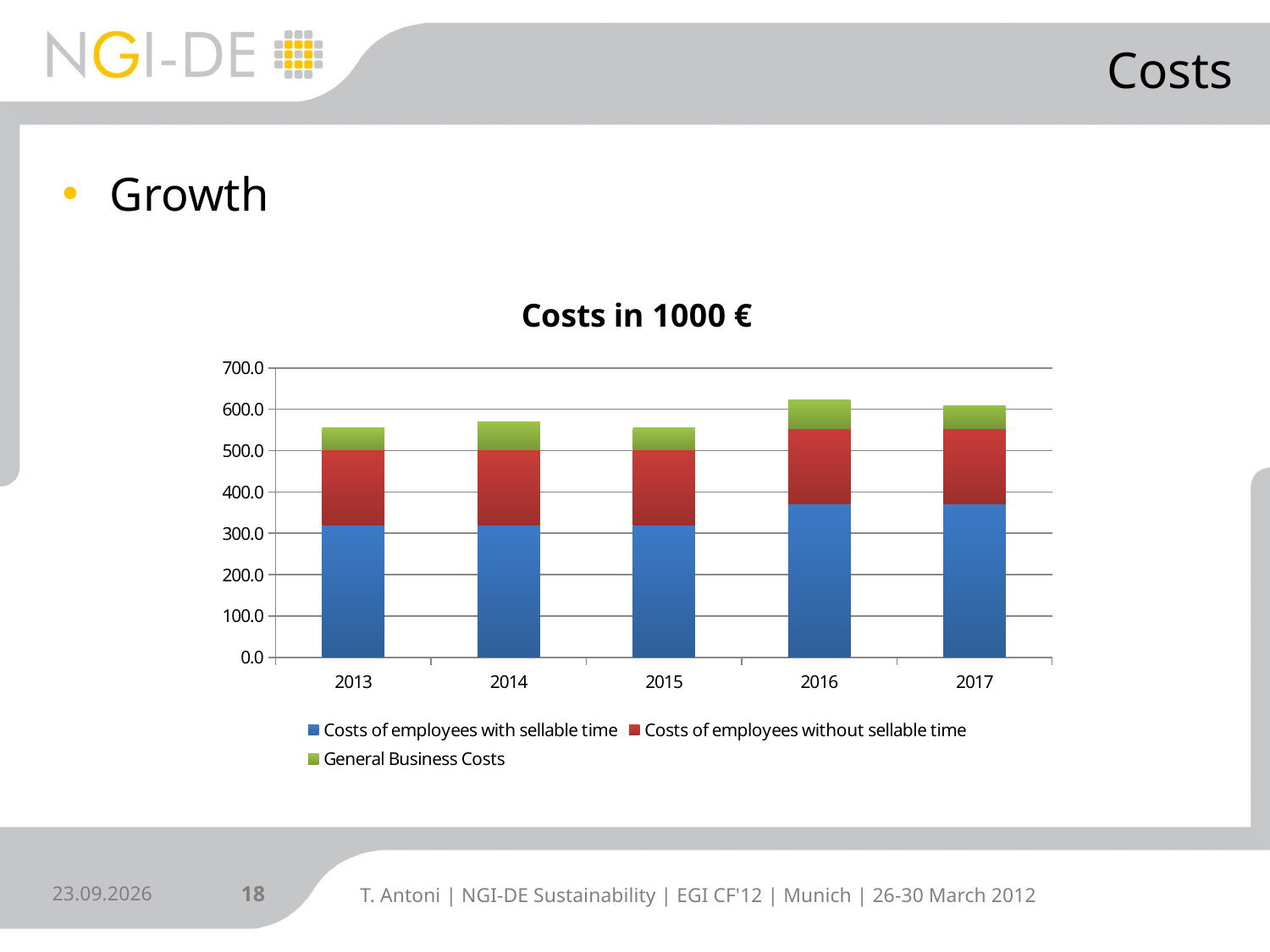
Is the total cost for 2014 greater or less than 500.0? greater What is the title of the chart? Costs in 1000 € Is the total cost for 2013 greater or less than 600.0? less Which year has a larger total cost, 2015 or 2016? 2016 Which series is shown in blue in the chart? Costs of employees with sellable time How many years are shown on the x axis of the chart? 5 Is the total cost for 2016 greater or less than 600.0? greater What kind of chart is shown on the slide? Stacked bar chart How many series does the chart's legend list? 3 Which year has a larger total cost, 2013 or 2017? 2017